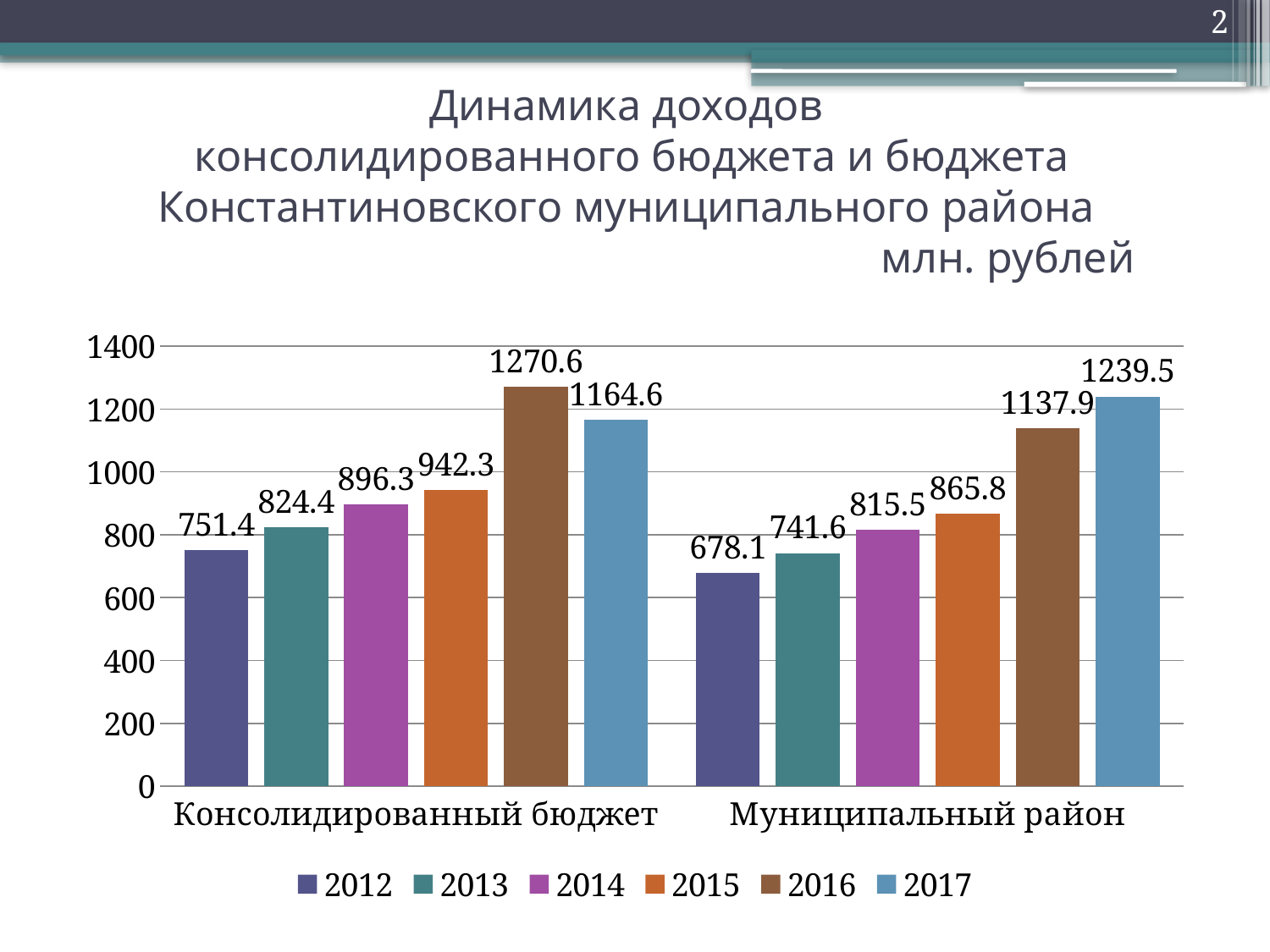
What is the value for 2012 in the Муниципальный район group? 678.1 How many categories are shown on the x axis? 2 Is the 2014 value for Муниципальный район greater or less than 1000? less Which is larger: the 2015 value for Консолидированный бюджет or the 2015 value for Муниципальный район? Консолидированный бюджет What is the value for 2017 in the Муниципальный район group? 1239.5 Which year has the highest value in the Консолидированный бюджет group? 2016 What unit of measurement is stated in the slide title? млн. рублей How many series does the legend list? 6 What kind of chart is shown on the slide? bar chart What is the difference between the 2017 and 2012 values in the Консолидированный бюджет group? 413.2 What is the value for 2016 in the Консолидированный бюджет group? 1270.6 Which year has the lowest value in the Муниципальный район group? 2012